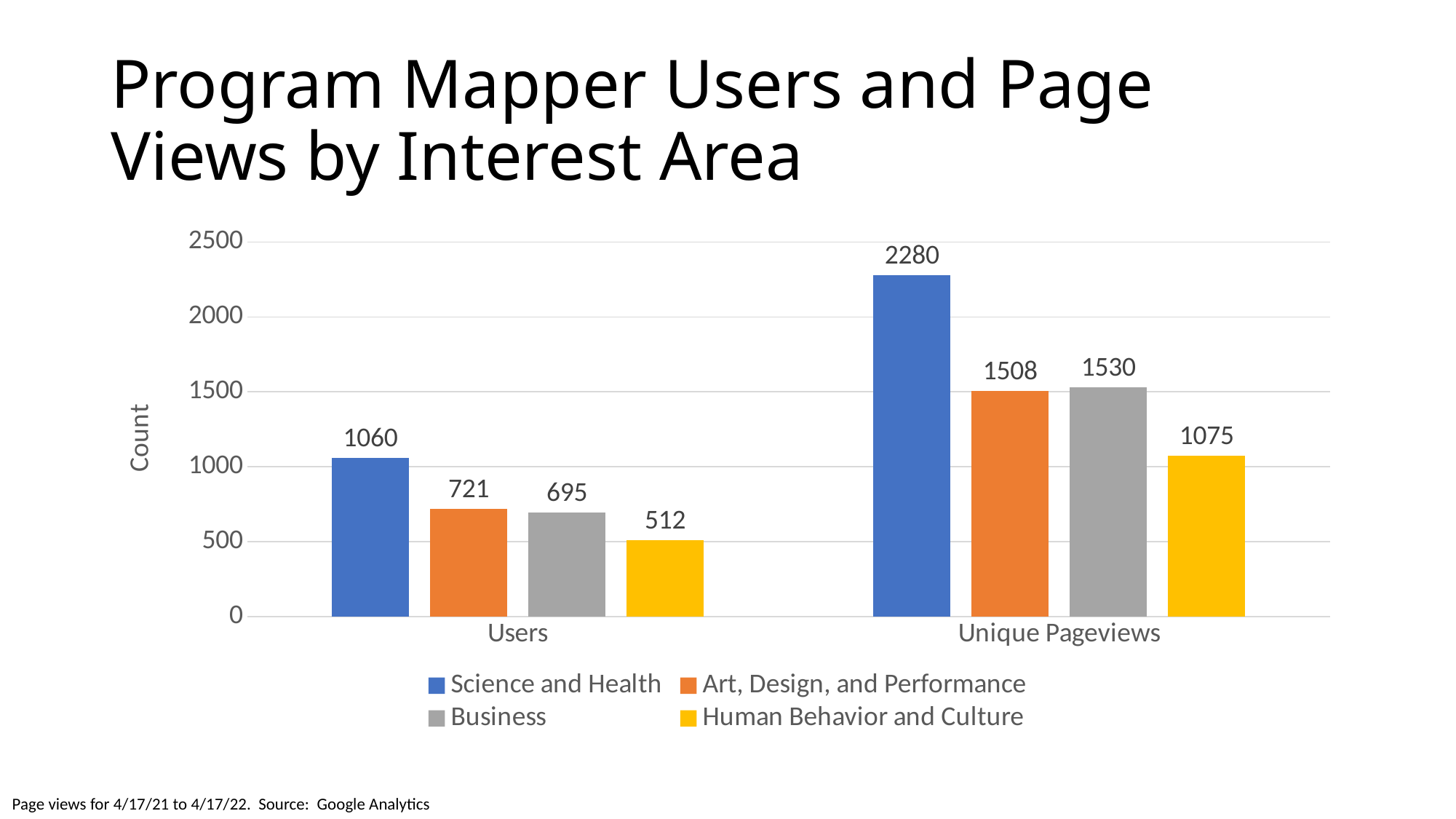
Which interest area has the highest number of Unique Pageviews? Science and Health What is the number of Users for Business? 695 Which is larger: Users for Art, Design, and Performance or Users for Business? Users for Art, Design, and Performance What is the difference between Unique Pageviews for Science and Health and for Art, Design, and Performance? 772 How many categories are shown on the x axis? 2 What is the number of Users for Science and Health? 1060 What is the number of Unique Pageviews for Human Behavior and Culture? 1075 What is the label of the y axis? Count How many series does the legend list? 4 Is the value for Unique Pageviews for Business greater or less than 1500? greater Which interest area has the lowest number of Users? Human Behavior and Culture What kind of chart is shown on the slide? Bar chart